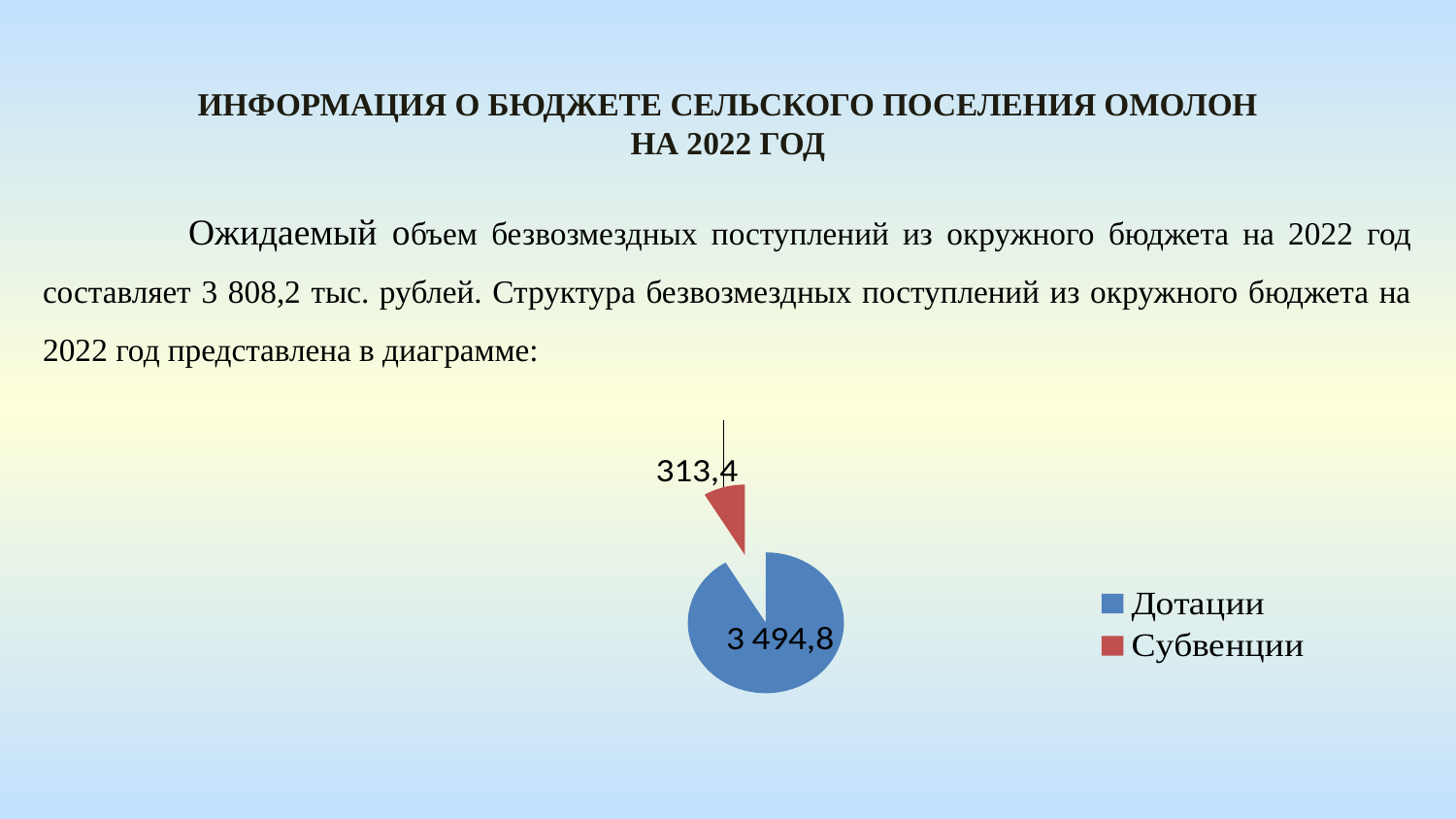
How many entries does the legend of the pie chart list? 2 What is the total of the two slices in the pie chart? 3 808,2 To the nearest whole percent, what share of the pie does Субвенции represent? 8% How many slices does the pie chart have? 2 What is the difference between the Дотации and Субвенции values in the pie chart? 3 181,4 What is the value of the Субвенции slice in the pie chart? 313,4 What is the value of the Дотации slice in the pie chart? 3 494,8 What colour is the Дотации slice in the pie chart? blue Which category has the largest slice in the pie chart? Дотации What type of chart is shown on the slide? pie chart Which is larger in the pie chart, Дотации or Субвенции? Дотации Which category has the smallest slice in the pie chart? Субвенции